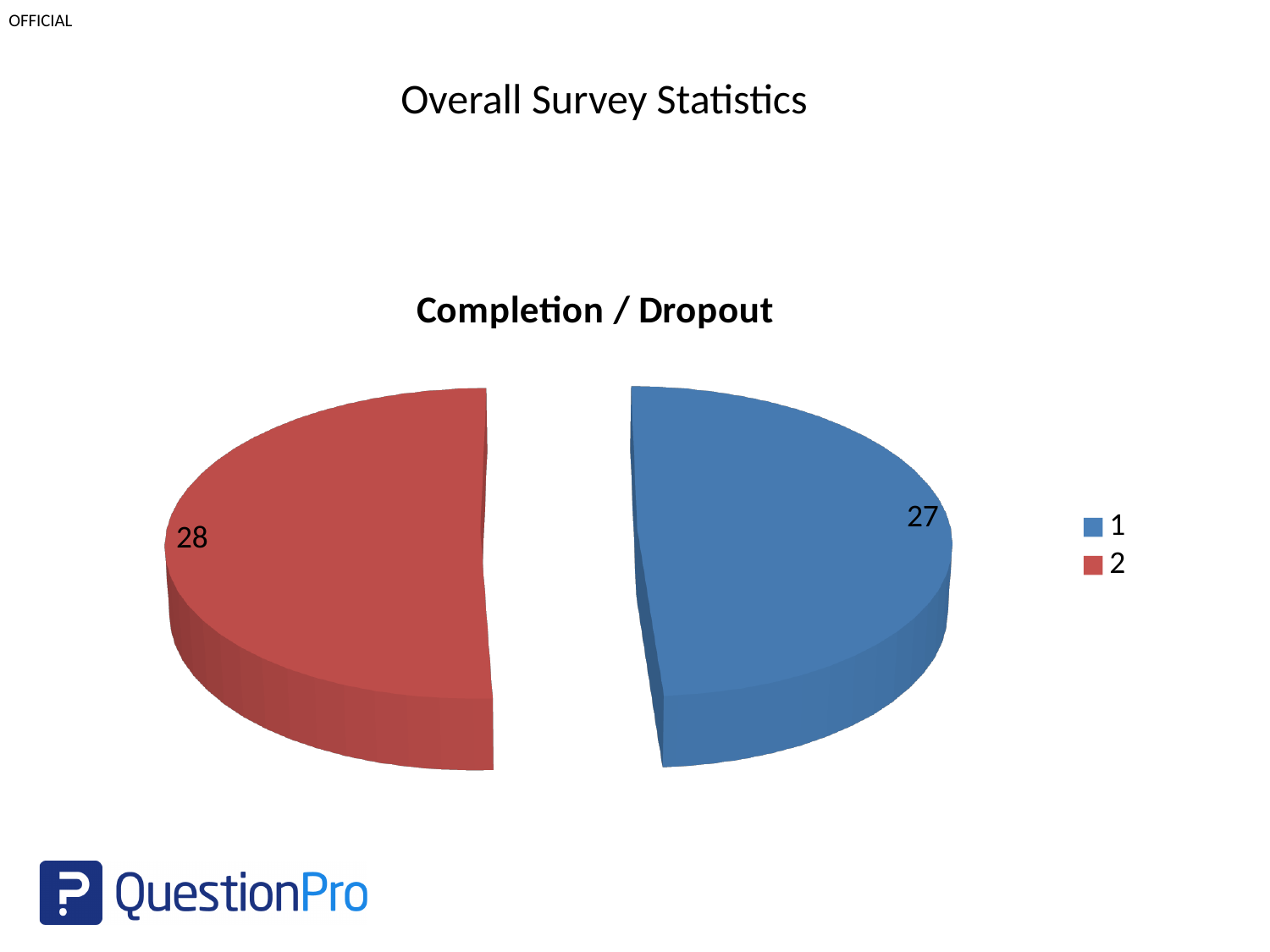
What is the value of slice 2 in the Completion / Dropout pie chart? 28 How many entries does the legend of the Completion / Dropout pie chart list? 2 Which category has the smaller value in the Completion / Dropout pie chart? 1 How many slices does the Completion / Dropout pie chart have? 2 What is the total of the two slice values in the Completion / Dropout pie chart? 55 What colour is the slice for category 2 in the Completion / Dropout pie chart? Red What is the difference between the values of slice 2 and slice 1 in the Completion / Dropout pie chart? 1 What is the title of the pie chart on the slide? Completion / Dropout Is the value for category 1 larger or smaller than the value for category 2 in the Completion / Dropout pie chart? Smaller What is the value of slice 1 in the Completion / Dropout pie chart? 27 What type of chart is shown under the title "Completion / Dropout"? Pie chart Which category has the larger value in the Completion / Dropout pie chart? 2